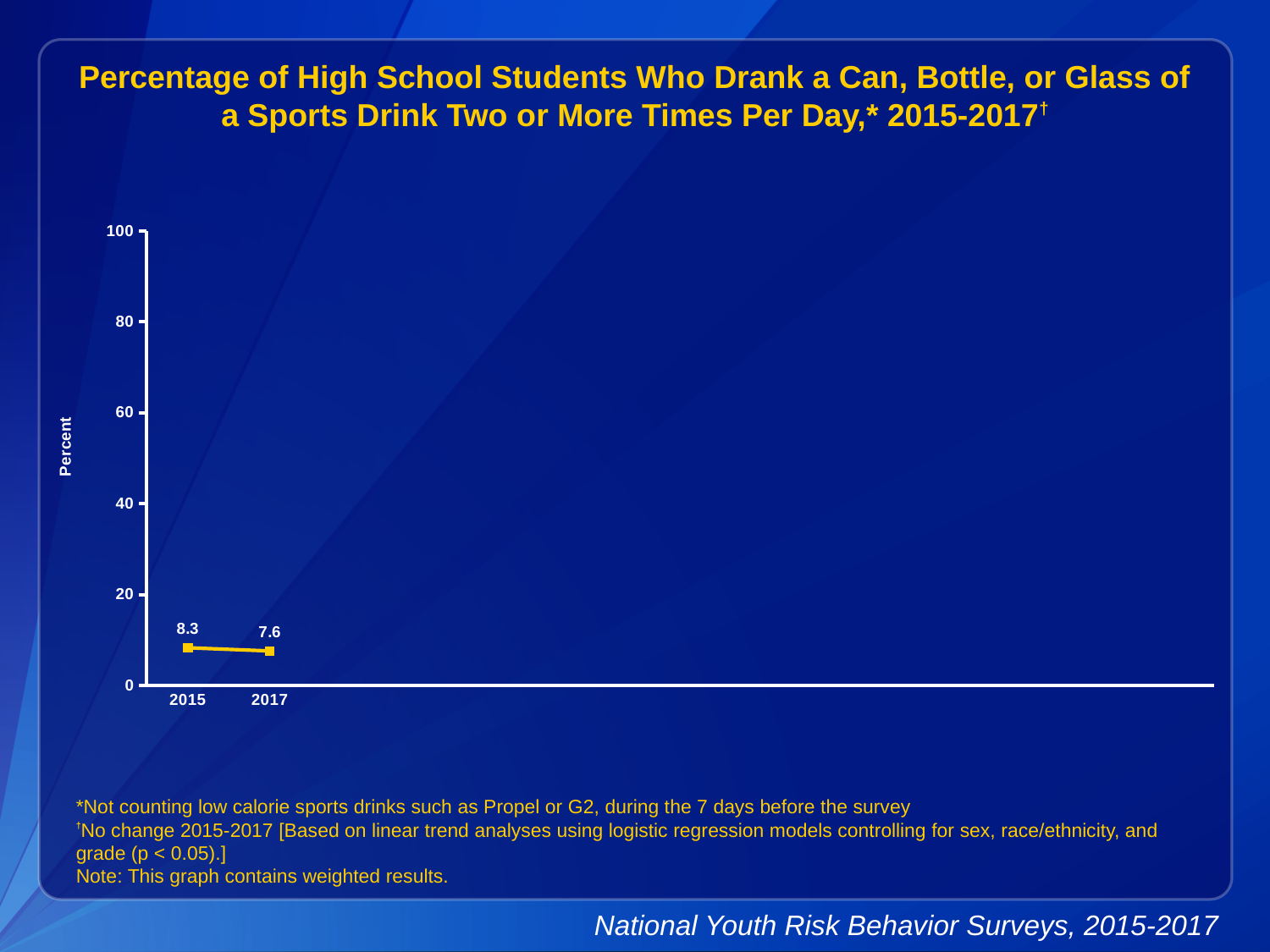
Is the value for 2017 greater or less than 20? less What kind of chart is shown on the slide? line chart How many years are plotted on the chart? 2 What is the difference between the 2015 and 2017 values? 0.7 What is the label on the y axis? Percent What is the maximum value shown on the y axis? 100 Which year shows the lowest percentage? 2017 Do the values rise or fall from 2015 to 2017? fall What percentage of high school students drank a sports drink two or more times per day in 2015? 8.3 What percentage of high school students drank a sports drink two or more times per day in 2017? 7.6 Which year has the higher value, 2015 or 2017? 2015